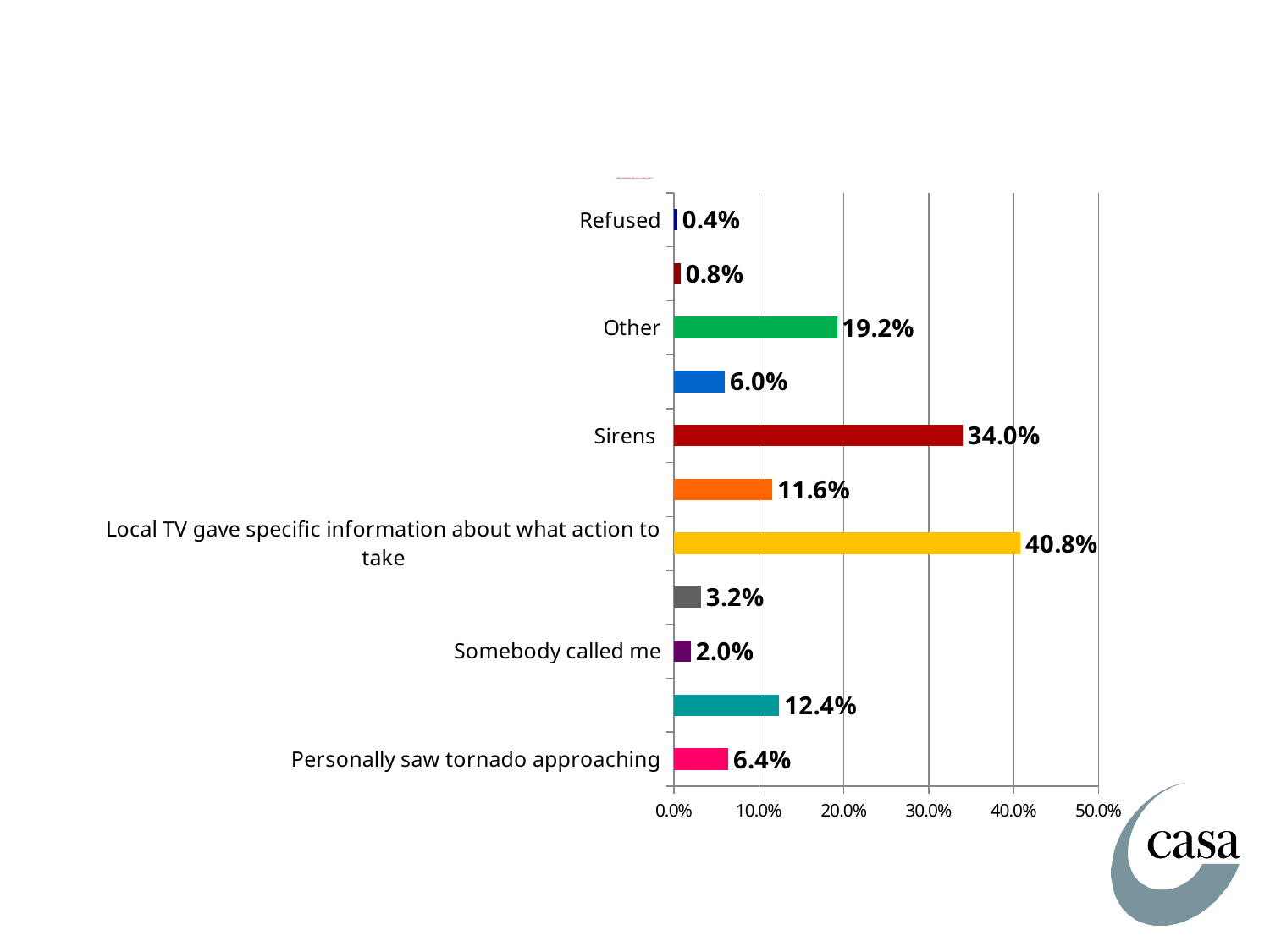
Which category has the lowest value? Refused What is the value for Refused? 0.4% What is the value for Personally saw tornado approaching? 6.4% Which category has the highest value? Local TV gave specific information about what action to take Which is larger, the value for Other or the value for Personally saw tornado approaching? Other What is the value for Other? 19.2% What is the difference between the values for Local TV gave specific information about what action to take and Sirens? 6.8% What is the value for Sirens? 34.0% How many bars are plotted in the chart? 11 What is the value for Somebody called me? 2.0% Is the value for Sirens greater or less than 30.0%? greater What kind of chart is shown on the slide? Bar chart